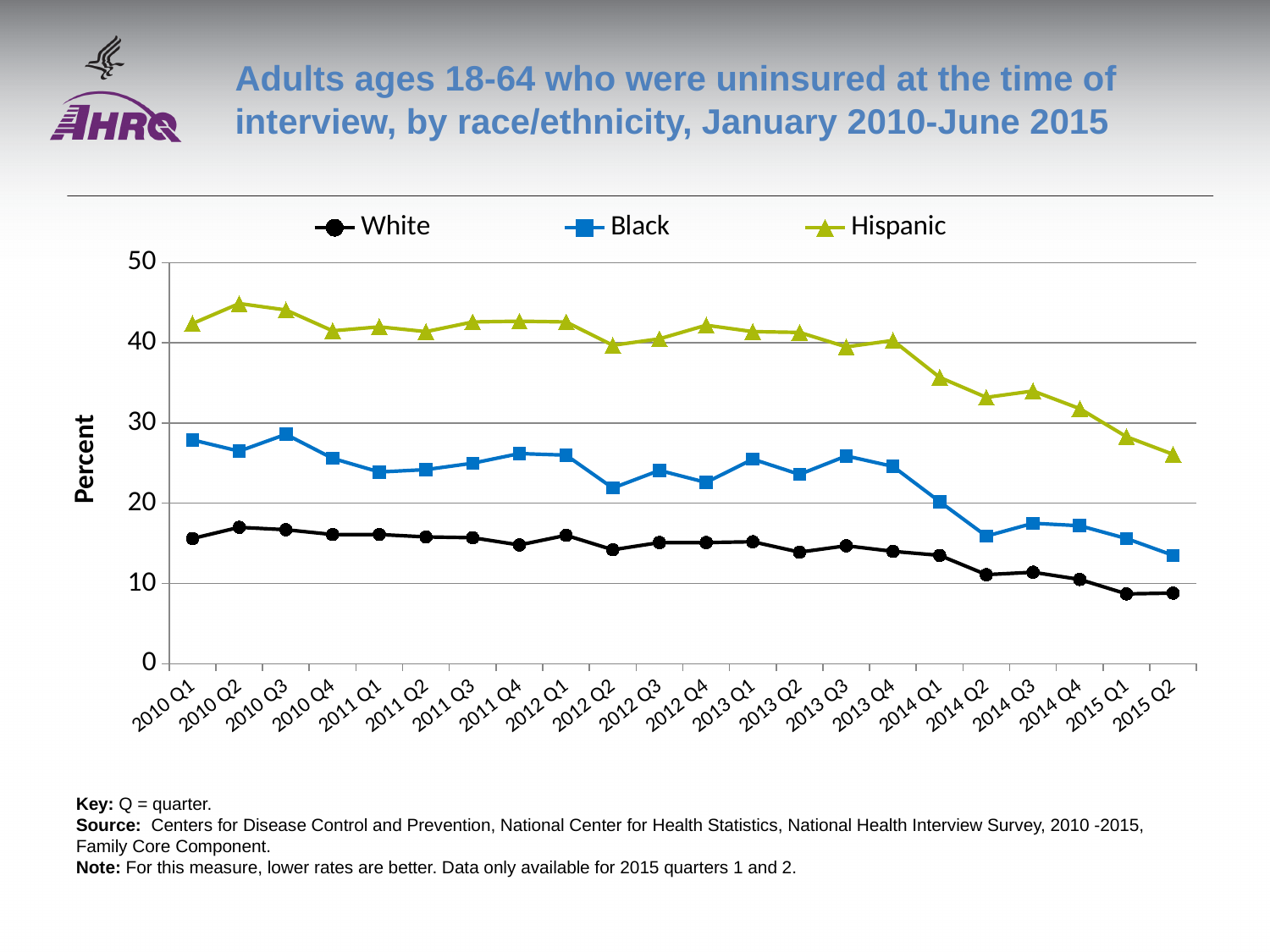
How many series does the legend list? 3 Is the value for Black in 2015 Q2 greater or less than 20? less Which series has the lowest uninsured rate across all quarters shown? White Is the value for Hispanic in 2010 Q2 greater or less than 40? greater Does the White series rise or fall overall from 2010 Q1 to 2015 Q2? Fall Is the value for Hispanic in 2015 Q2 greater or less than 30? less In 2015 Q2, which is larger, the value for Black or the value for White? Black How many quarters are plotted along the x axis? 22 What kind of chart is shown on the slide? Line chart What is the label on the y axis? Percent Which series has the highest uninsured rate across all quarters shown? Hispanic